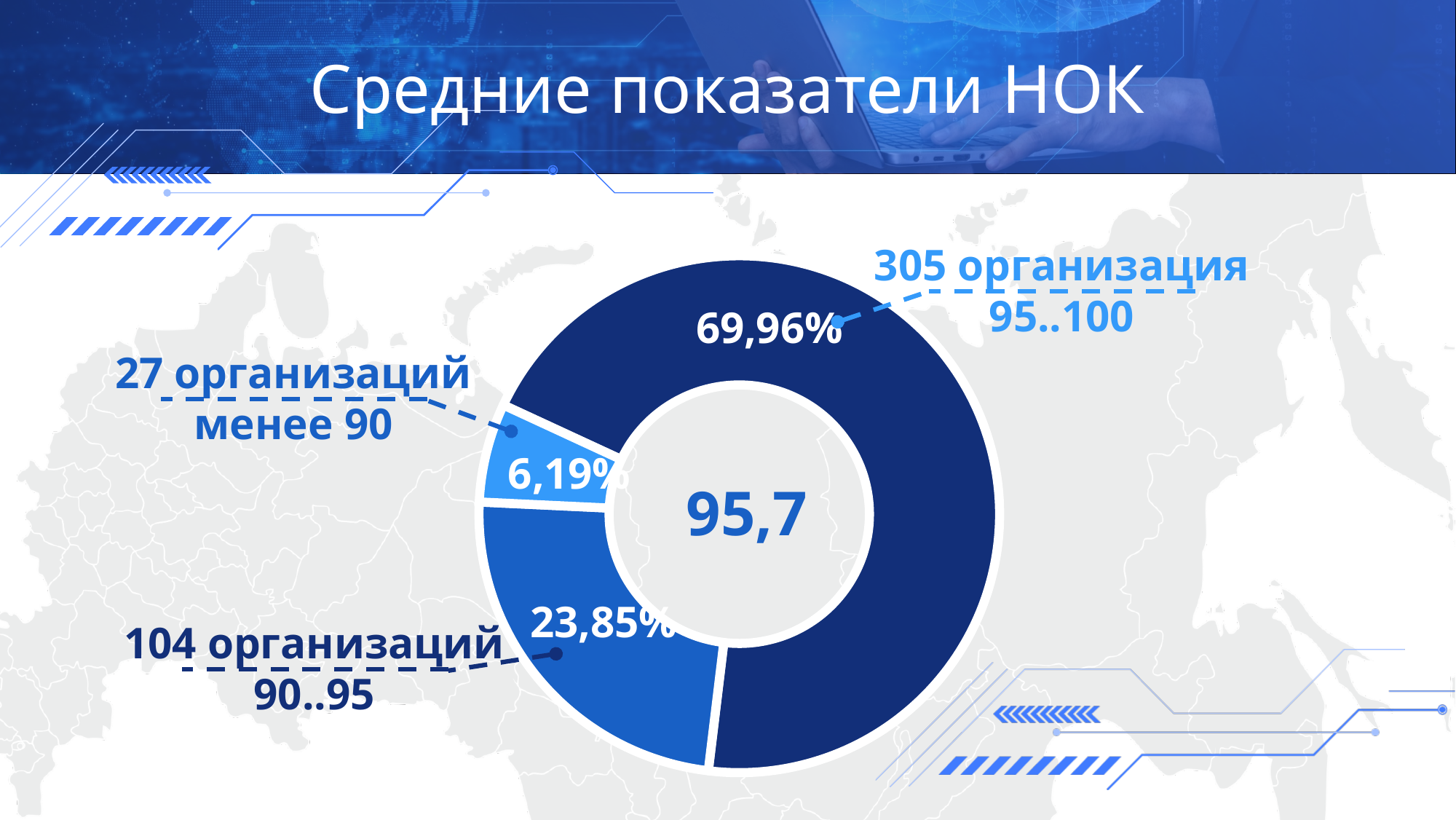
What is the title of the slide containing the chart? Средние показатели НОК Which group has the largest share of the chart? 305 организация, 95..100 What share of the chart corresponds to the 27 organisations with scores below 90 (менее 90)? 6,19% What share of the chart corresponds to the 104 organisations with scores 90..95? 23,85% Which slice is larger: the 90..95 group or the менее 90 group? 90..95 group (23,85%) What share of the chart corresponds to the 305 organisations with scores 95..100? 69,96% How many slices does the donut chart have? 3 What is the difference in percentage points between the 95..100 slice and the 90..95 slice? 46,11 What kind of chart is shown on the slide? Donut (pie) chart Which group has the smallest share of the chart? 27 организаций, менее 90 How many organisations are in the 90..95 group? 104 What value is printed in the centre of the donut chart? 95,7